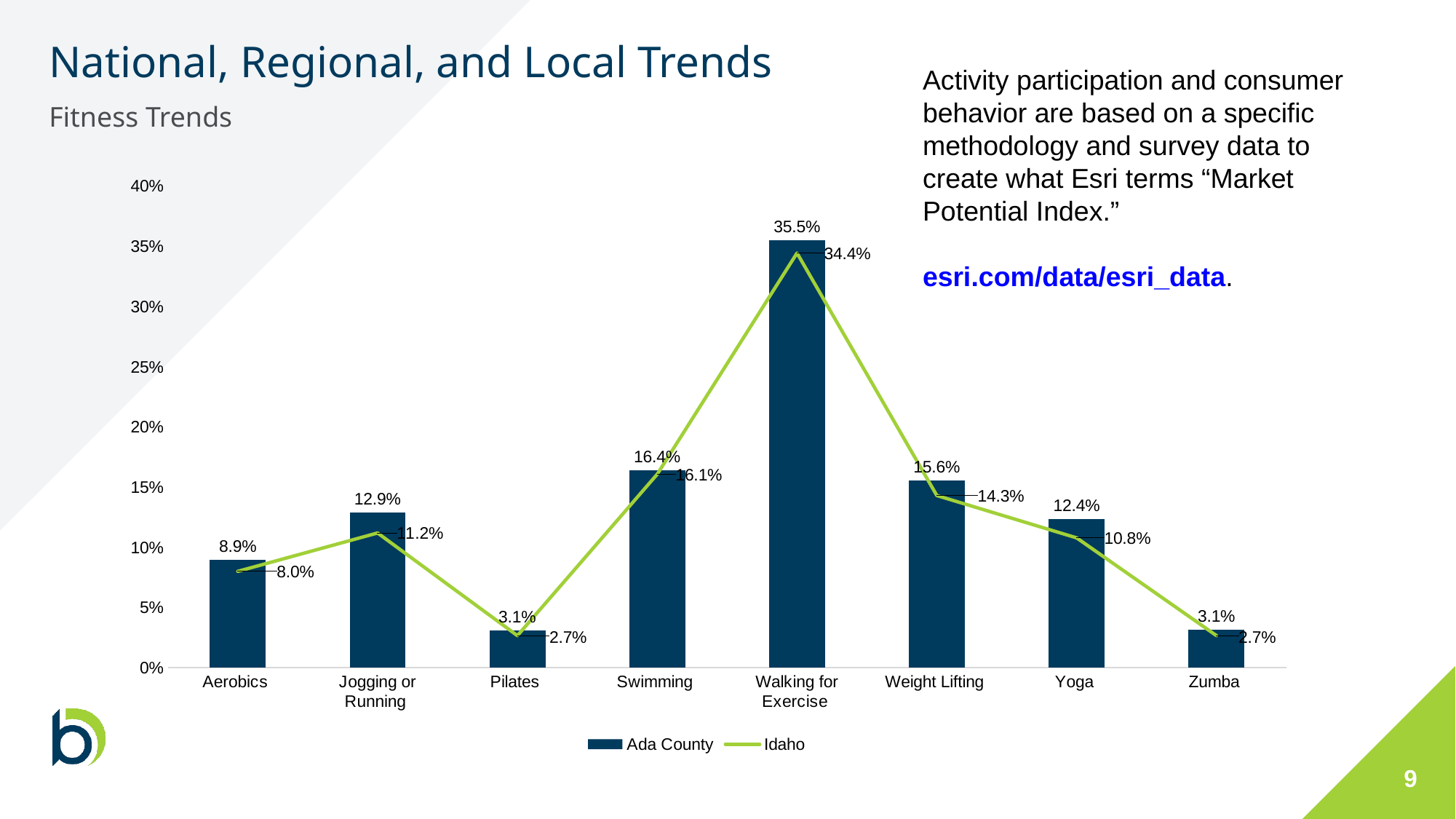
What is the Idaho value for Aerobics? 8.0% What is the Ada County value for Swimming? 16.4% Which activity has the lowest Idaho value? Pilates and Zumba (both 2.7%) What is the difference between the Ada County and Idaho values for Walking for Exercise? 1.1% How many series does the legend list? 2 Which is larger for Yoga, the Ada County value or the Idaho value? Ada County What kind of chart is shown on the slide? A combination bar and line chart How many activities are shown on the x axis? 8 Which activity has the highest Ada County value? Walking for Exercise Which series is drawn as a line in the chart? Idaho What is the Idaho value for Weight Lifting? 14.3% What is the Ada County value for Walking for Exercise? 35.5%